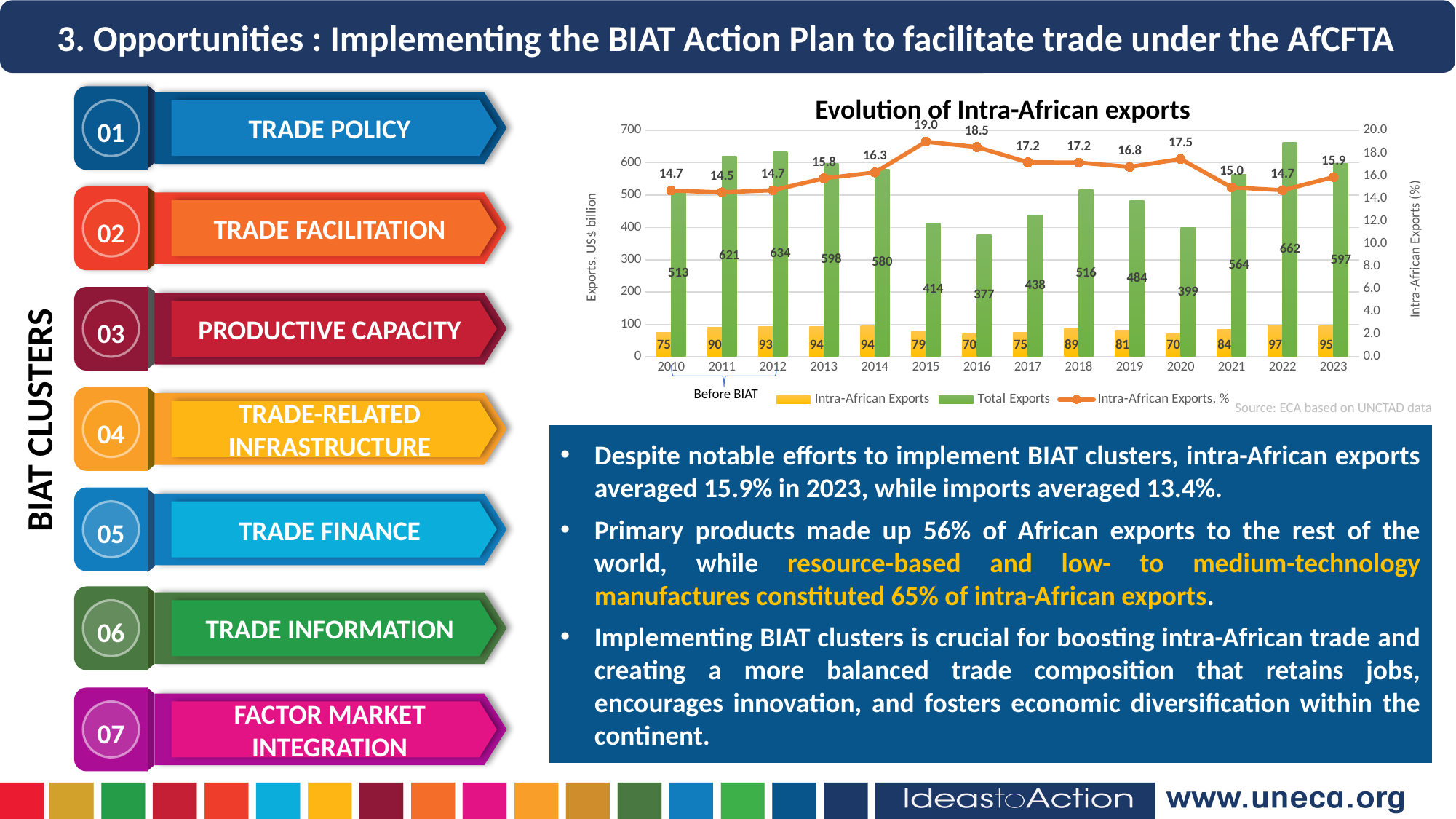
Which year had higher Intra-African Exports, 2013 or 2016? 2013 What was the Intra-African Exports, % value in 2015? 19.0 In which year was the Intra-African Exports, % value highest? 2015 In which year was Total Exports highest? 2022 What is the title of the chart on the slide? Evolution of Intra-African exports How many series does the chart legend list? 3 What is the difference between Total Exports in 2022 and in 2023? 65 How many years are shown on the x axis of the chart? 14 Did Total Exports rise or fall from 2012 to 2016? fall What was the value of Total Exports in 2012? 634 In which year was Total Exports lowest? 2016 What was the value of Intra-African Exports in 2022? 97